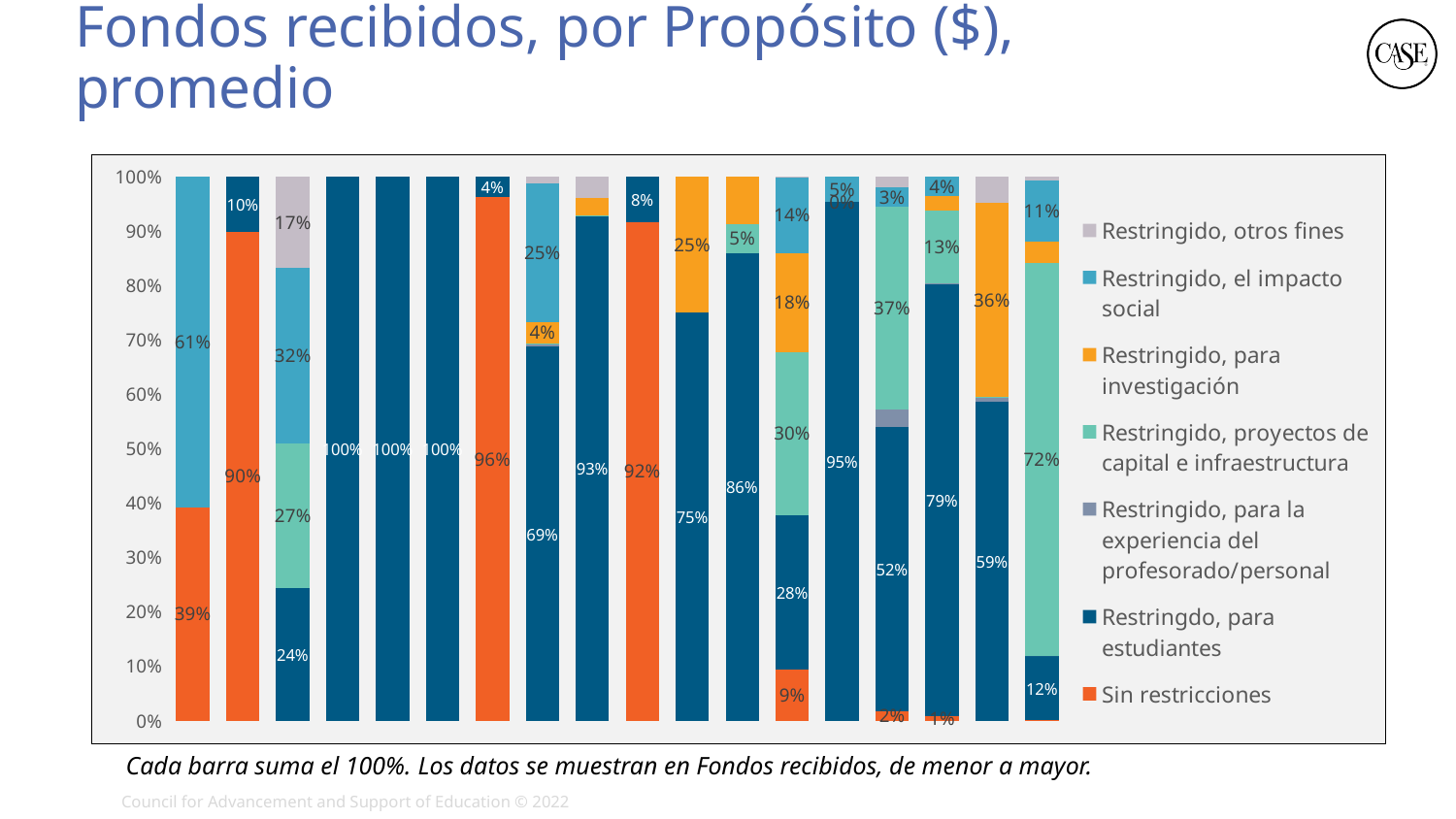
Which legend entry is shown in orange? Sin restricciones How many bars are plotted in the chart? 18 In the first (leftmost) bar, what percentage is labeled for the 'Sin restricciones' segment? 39% In the second bar from the left, what percentage is labeled for the 'Sin restricciones' segment? 90% In the third bar from the left, what is the difference between the 'Restringido, el impacto social' segment (32%) and the 'Restringdo, para estudiantes' segment (24%)? 8% How many series does the legend list? 7 In the third bar from the left, what percentage is labeled for the 'Restringido, otros fines' segment? 17% In the first (leftmost) bar, what percentage is labeled for the 'Restringido, el impacto social' segment? 61% What is the title of the chart slide? Fondos recibidos, por Propósito ($), promedio In the rightmost bar, what percentage is labeled for the 'Restringido, proyectos de capital e infraestructura' segment? 72% What kind of chart is shown on the slide? Stacked bar chart In the third bar from the left, which is larger: the 'Restringido, el impacto social' segment or the 'Restringido, proyectos de capital e infraestructura' segment? Restringido, el impacto social